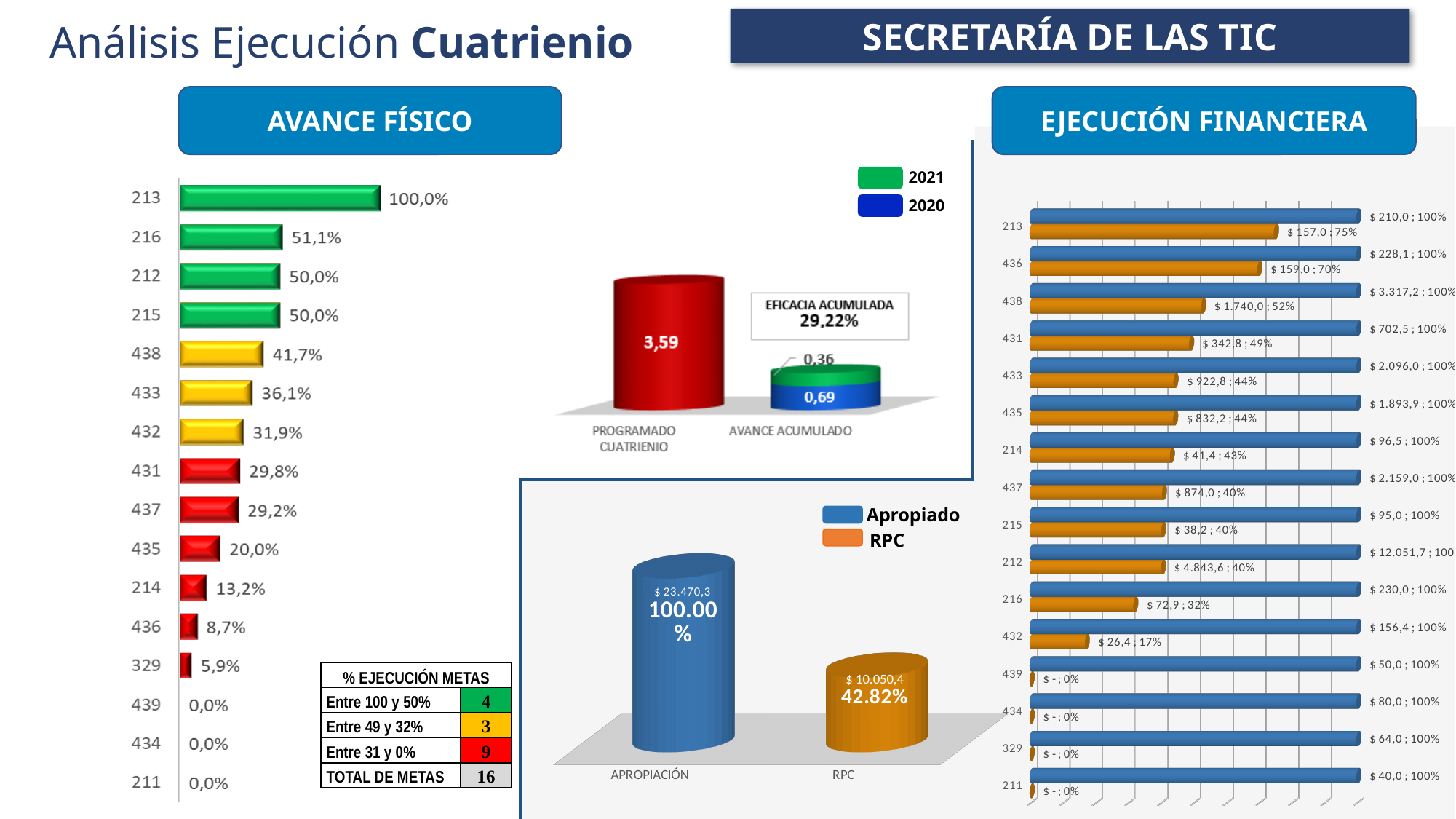
In the EJECUCIÓN FINANCIERA chart, what is the RPC value for category 438? $ 1.740,0 ; 52% In the AVANCE FÍSICO chart, what is the difference between the values for 216 and 212? 1,1% In the AVANCE FÍSICO chart, which category has the highest value? 213 In the AVANCE FÍSICO chart, what is the value for category 213? 100,0% In the AVANCE FÍSICO chart, how many categories are plotted? 16 What kind of chart is the EJECUCIÓN FINANCIERA chart? bar chart In the PROGRAMADO CUATRIENIO vs AVANCE ACUMULADO chart, what is the total of the AVANCE ACUMULADO stacked bar? 1,05 In the PROGRAMADO CUATRIENIO vs AVANCE ACUMULADO chart, what is the value for PROGRAMADO CUATRIENIO? 3,59 In the AVANCE FÍSICO chart, what is the value for category 438? 41,7% In the PROGRAMADO CUATRIENIO vs AVANCE ACUMULADO chart, how many series does the legend list? 2 In the APROPIACIÓN vs RPC chart at the bottom centre, what value is shown for RPC? $ 10.050,4 In the EJECUCIÓN FINANCIERA chart, which category has the larger RPC value, 438 or 431? 438